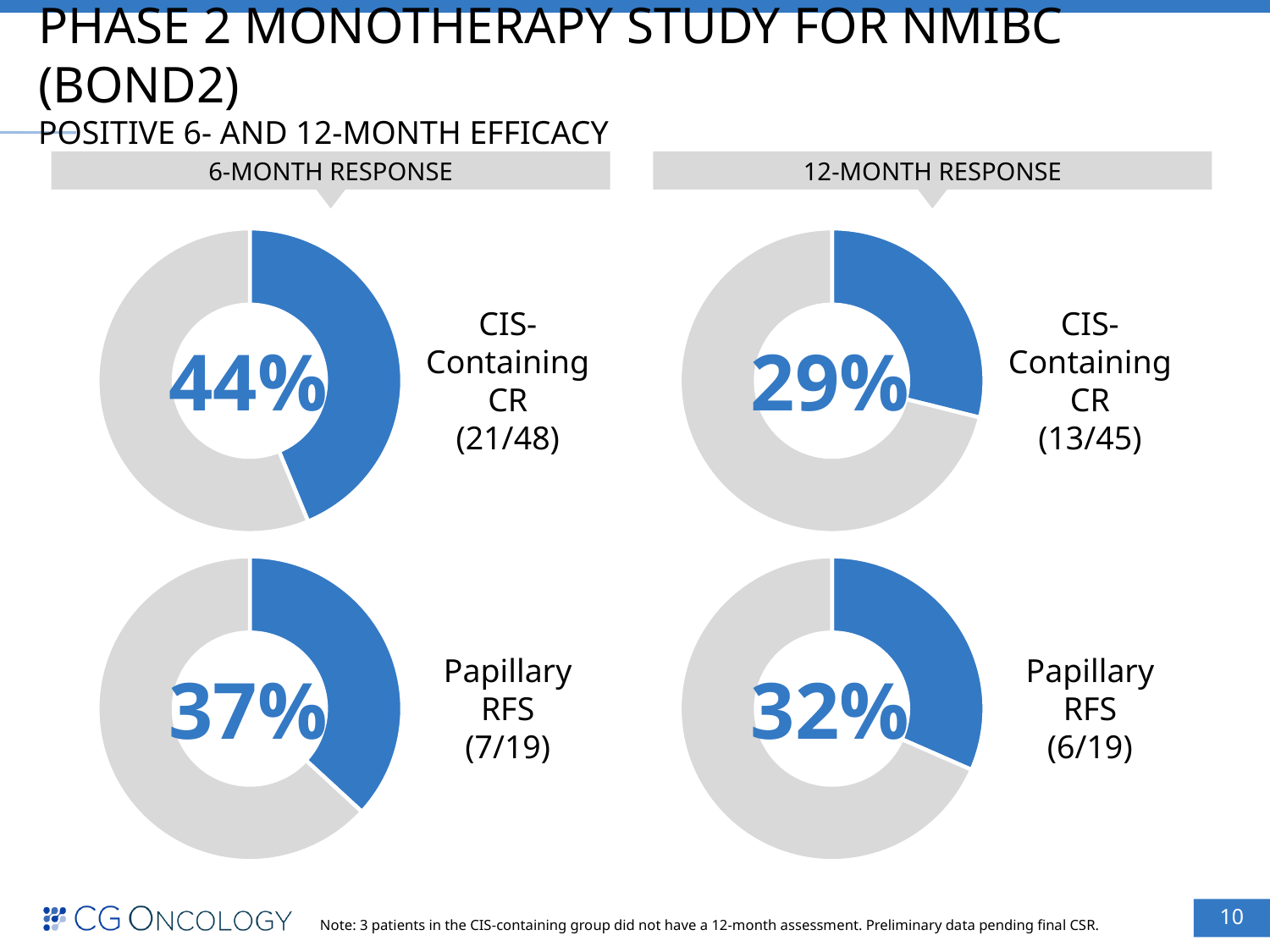
How many donut charts are shown on the slide? 4 In the 6-month response section, what patient fraction is given for the CIS-Containing CR chart? 21/48 Which of the four donut charts shows the lowest percentage? 12-month CIS-Containing CR (29%) Which is larger: the 6-month Papillary RFS percentage or the 12-month Papillary RFS percentage? 6-month Papillary RFS (37%) Which of the four donut charts shows the highest percentage? 6-month CIS-Containing CR (44%) What kind of chart is used to display the response percentages on this slide? Donut (pie) chart In the 12-month response section, what patient fraction is given for the Papillary RFS chart? 6/19 What is the difference in percentage points between the 6-month and 12-month CIS-Containing CR values? 15 percentage points In the 6-month response section, what percentage is shown in the Papillary RFS donut chart? 37% In the 12-month response section, what percentage is shown in the Papillary RFS donut chart? 32% In the 12-month response section, what percentage is shown in the CIS-Containing CR donut chart? 29% In the 6-month response section, what percentage is shown in the CIS-Containing CR donut chart? 44%